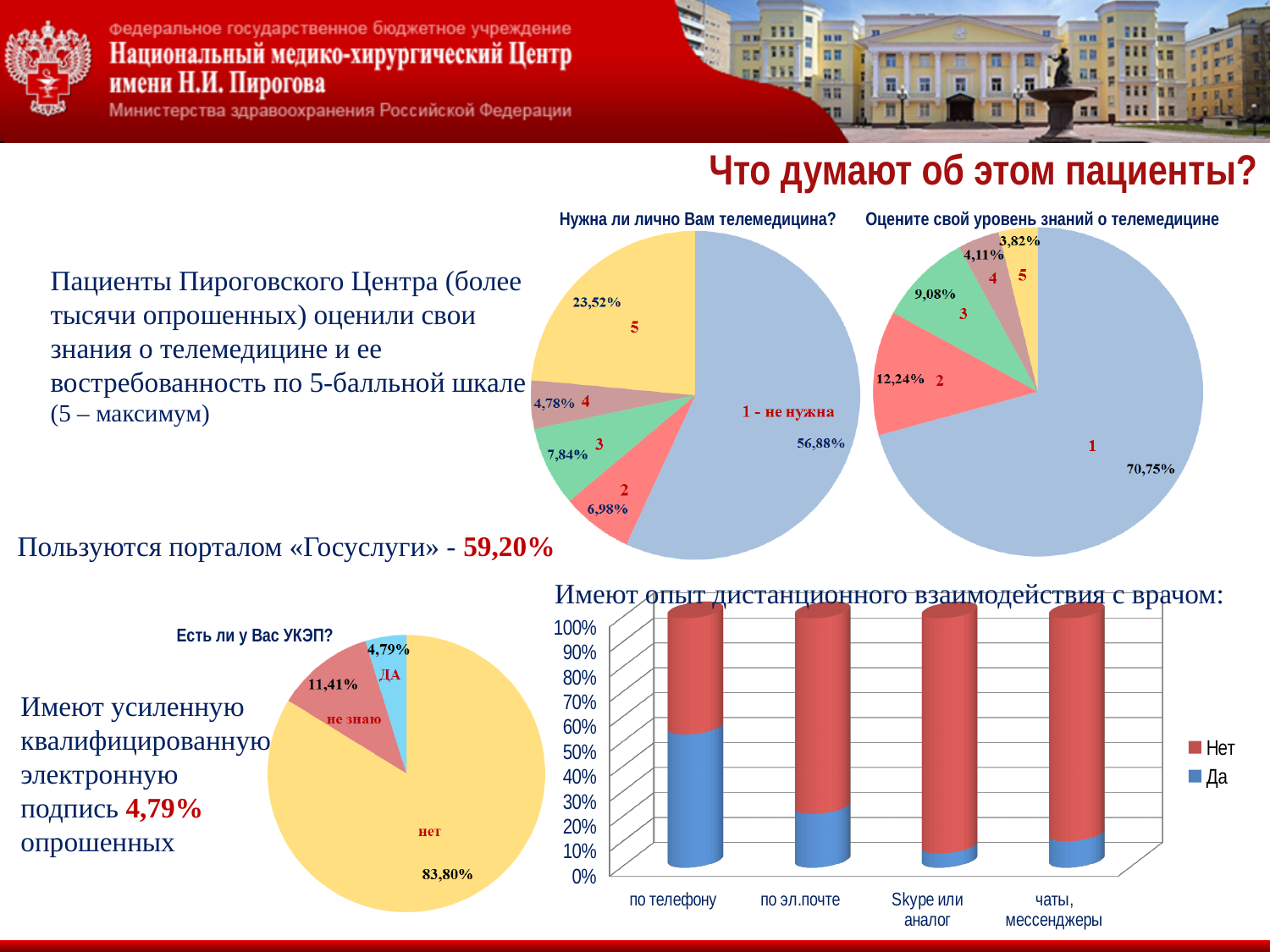
In the bar chart "Имеют опыт дистанционного взаимодействия с врачом", is the "Да" value for "по телефону" greater or less than 50%? greater In the pie chart "Оцените свой уровень знаний о телемедицине", what is the share for rating 1? 70,75% In the pie chart "Нужна ли лично Вам телемедицина?", which rating has the smallest share? 4 How many slices does the pie chart "Есть ли у Вас УКЭП?" have? 3 In the bar chart "Имеют опыт дистанционного взаимодействия с врачом", which category has the largest "Да" share? по телефону In the pie chart "Нужна ли лично Вам телемедицина?", what share is labelled "1 - не нужна"? 56,88% In the pie chart "Оцените свой уровень знаний о телемедицине", which rating has the smallest share? 5 In the pie chart "Оцените свой уровень знаний о телемедицине", which is larger: the share for rating 2 or rating 3? 2 In the pie chart "Нужна ли лично Вам телемедицина?", what is the share for rating 5? 23,52% In the pie chart "Нужна ли лично Вам телемедицина?", what is the difference between the shares for rating 3 and rating 2? 0,86% In the bar chart "Имеют опыт дистанционного взаимодействия с врачом", how many series does the legend list? 2 In the pie chart "Есть ли у Вас УКЭП?", what is the share for "не знаю"? 11,41%